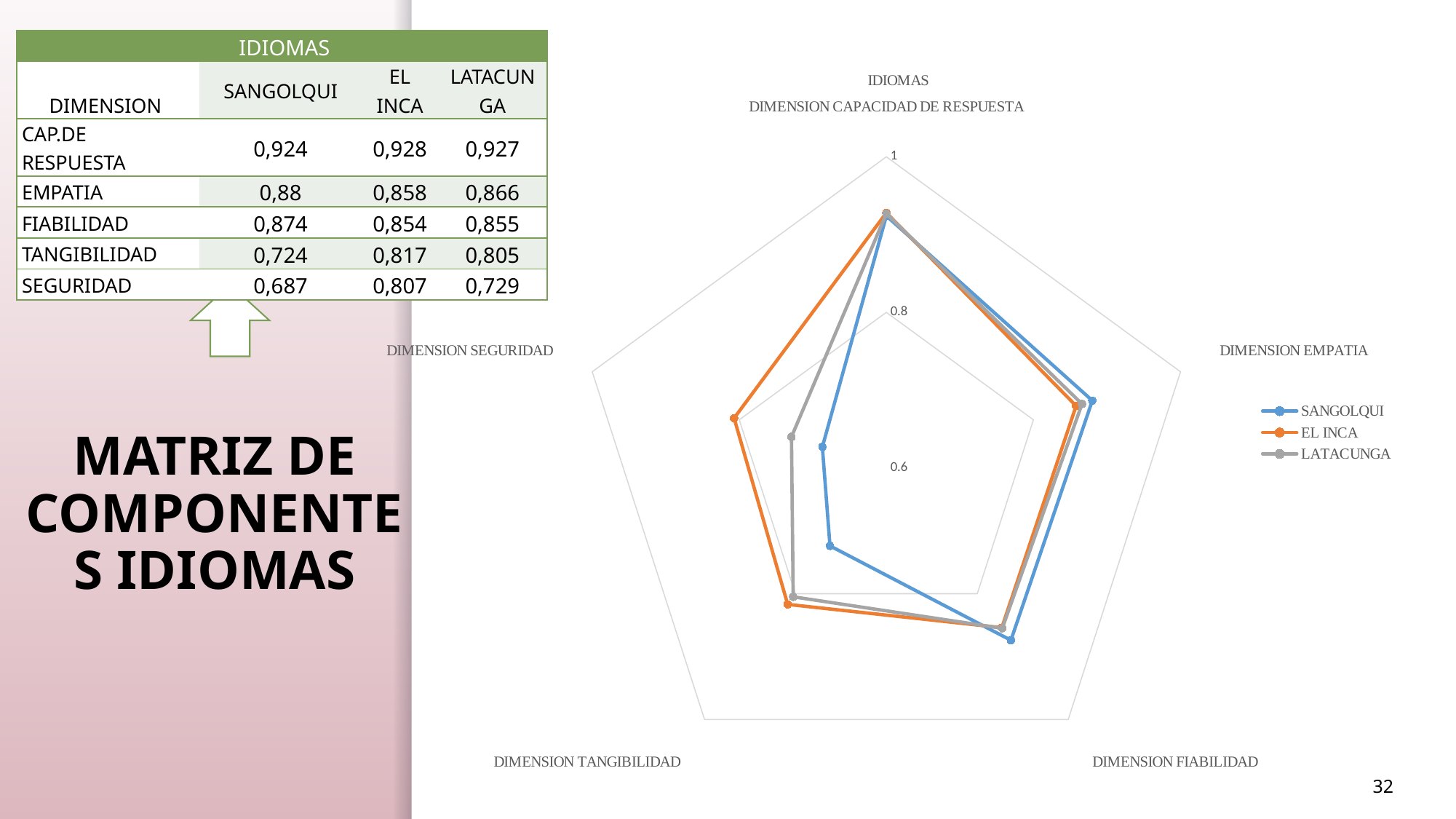
What is the value for EL INCA on DIMENSION TANGIBILIDAD? 0,817 Is the value for SANGOLQUI on DIMENSION SEGURIDAD greater or less than 0.8? less What kind of chart is shown on the slide? Radar chart How many series does the chart legend list? 3 Is the value for SANGOLQUI on DIMENSION CAPACIDAD DE RESPUESTA greater or less than 0.8? greater How many dimensions (axes) does the radar chart have? 5 What is the difference between EL INCA and SANGOLQUI on DIMENSION SEGURIDAD? 0,12 Which series has the highest value on DIMENSION TANGIBILIDAD? EL INCA What is the value for SANGOLQUI on DIMENSION SEGURIDAD? 0,687 On which dimension does SANGOLQUI have its lowest value? DIMENSION SEGURIDAD On DIMENSION SEGURIDAD, which is larger: EL INCA or SANGOLQUI? EL INCA Which series is drawn in orange on the chart? EL INCA